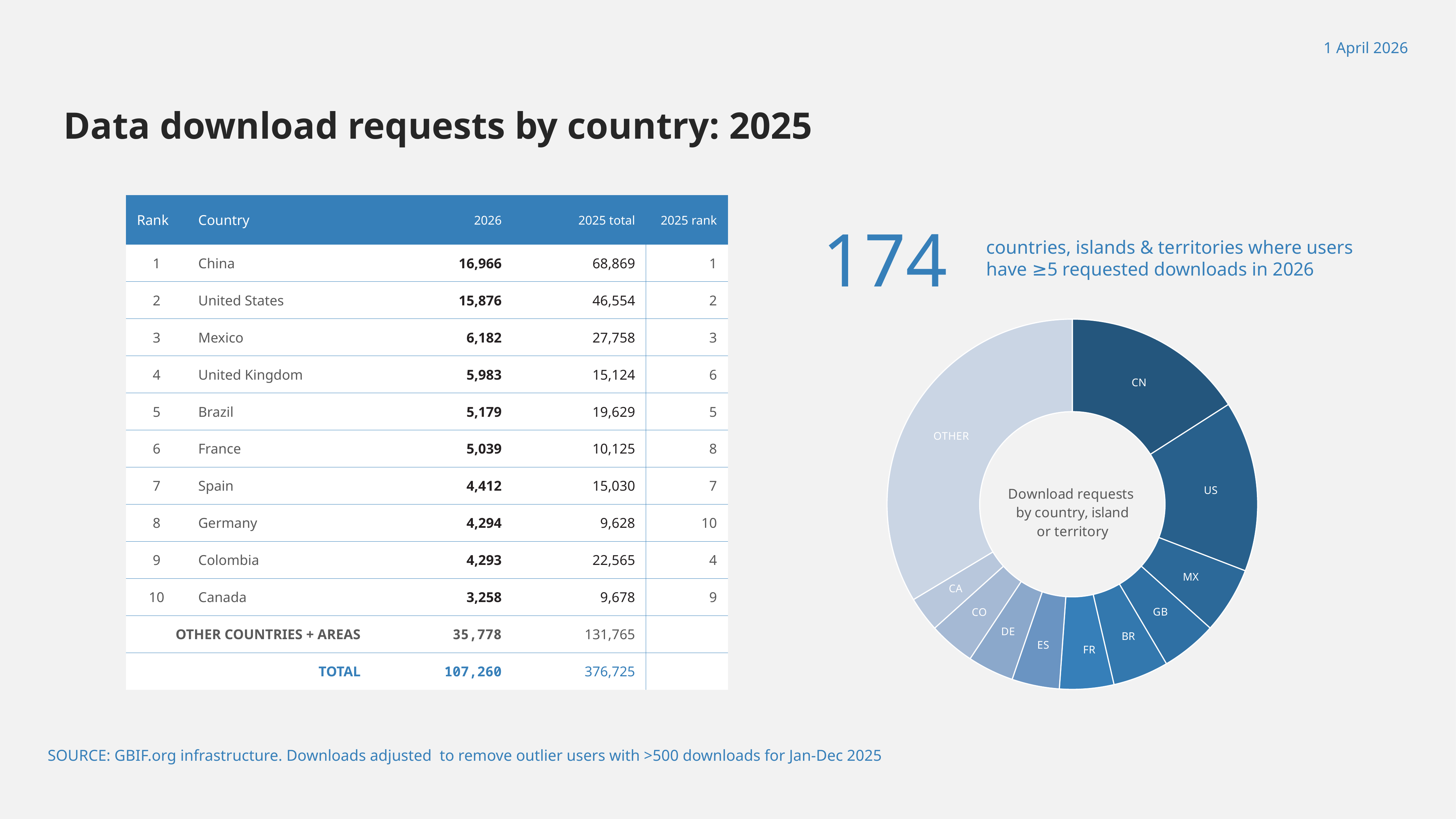
In the pie chart, which slice is larger, MX or CA? MX In the pie chart, which slice is larger, GB or DE? GB In the pie chart, which slice is larger, CN or MX? CN How many slices does the pie chart have? 11 Which slice of the pie chart is the largest? OTHER Excluding the OTHER slice, which country slice of the pie chart is the largest? CN What text is written in the centre of the pie chart? Download requests by country, island or territory What kind of chart is shown on the right of the slide? doughnut chart Which slice of the pie chart is the smallest? CA Which slice of the pie chart is shaded the lightest blue? OTHER